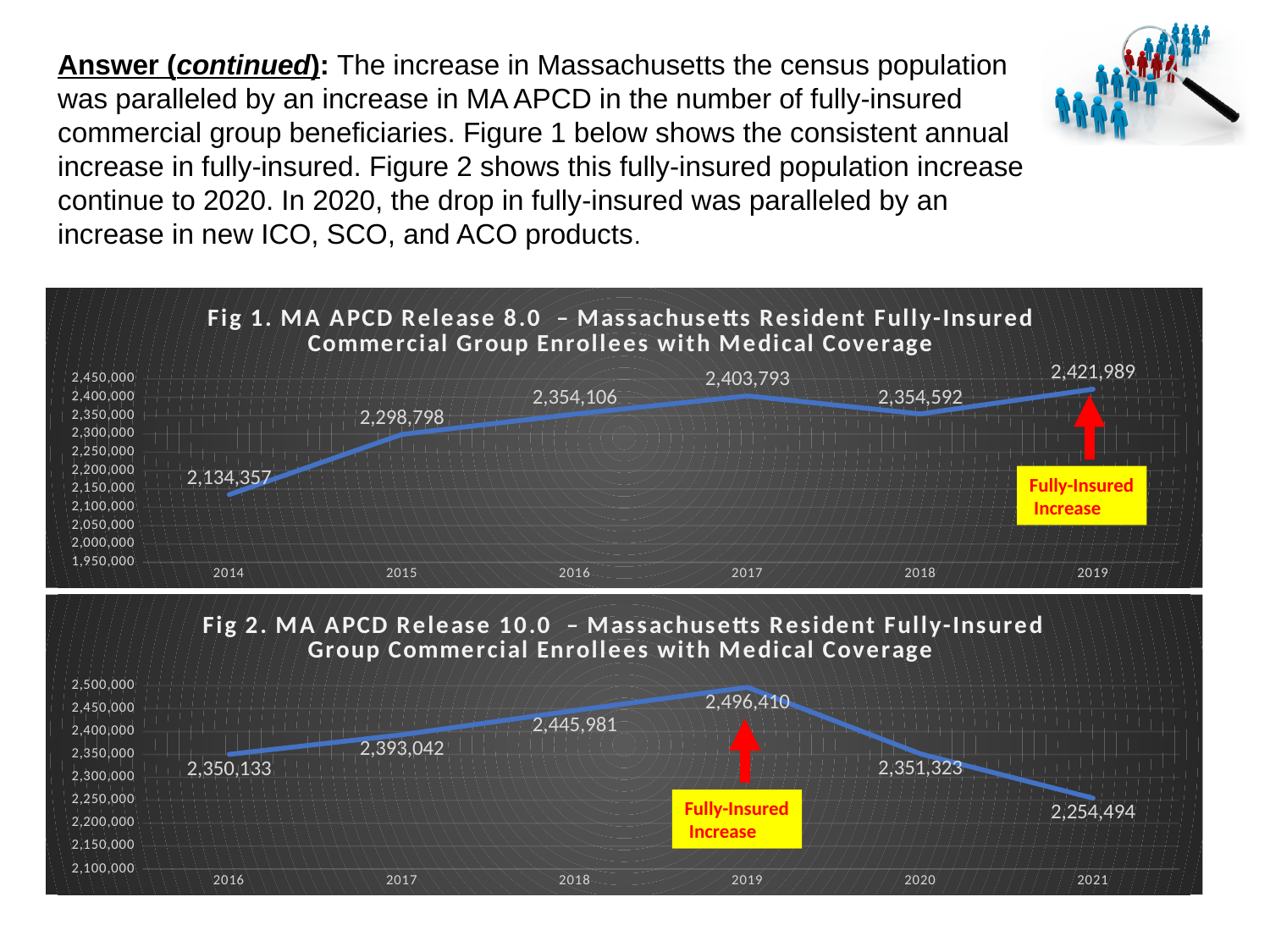
In Fig 1, what is the number of fully-insured commercial group enrollees in 2014? 2,134,357 In Fig 2, what is the value for 2019? 2,496,410 In Fig 2, what is the value for 2021? 2,254,494 In Fig 1, what is the difference between the 2019 value and the 2014 value? 287,632 In Fig 1, which year has the lowest value? 2014 In Fig 2, what is the difference between the 2019 value and the 2021 value? 241,916 In Fig 2, which year has the lowest value? 2021 In Fig 1, which year has the highest value? 2019 In Fig 1, how many years are plotted on the x axis? 6 In Fig 2, which is larger, the value for 2018 or the value for 2020? 2018 In Fig 1, what is the value for 2017? 2,403,793 What type of chart is Fig 2? Line chart